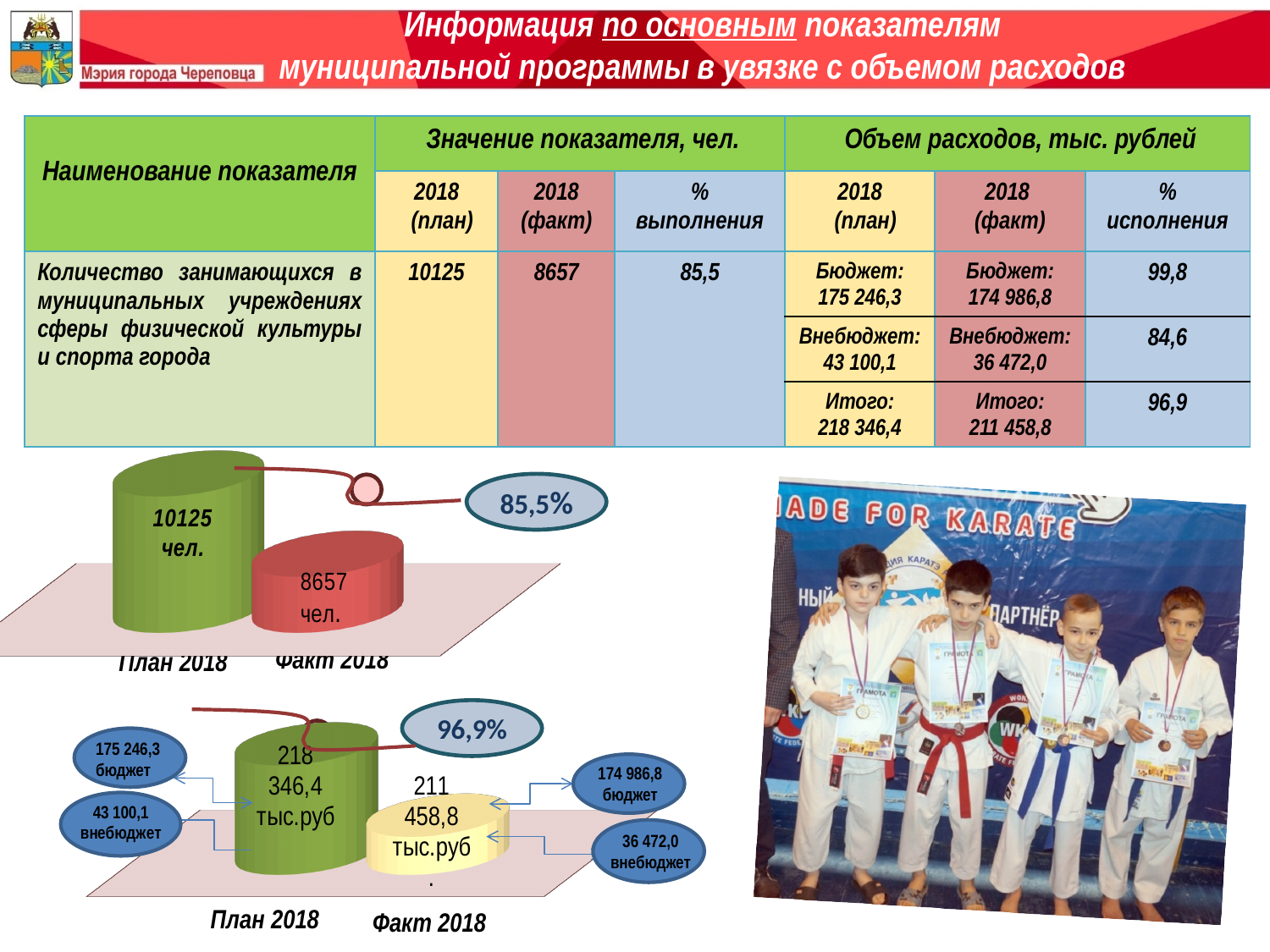
In the lower-left chart, what is the value for Факт 2018? 211 458,8 тыс.руб In the upper-left chart, how many bars are plotted? 2 In the lower-left chart, which category has the lower value? Факт 2018 In the upper-left chart, what is the value for План 2018? 10125 чел. In the upper-left chart, what percentage is shown in the callout? 85,5% In the upper-left chart, what is the difference between План 2018 and Факт 2018? 1468 чел. In the upper-left chart, what is the value for Факт 2018? 8657 чел. In the upper-left chart, which category has the higher value, План 2018 or Факт 2018? План 2018 What type of chart is the upper-left chart? bar chart In the lower-left chart, do the values fall or rise from План 2018 to Факт 2018? fall In the lower-left chart, what percentage is shown in the callout? 96,9% In the lower-left chart, what is the value for План 2018? 218 346,4 тыс.руб